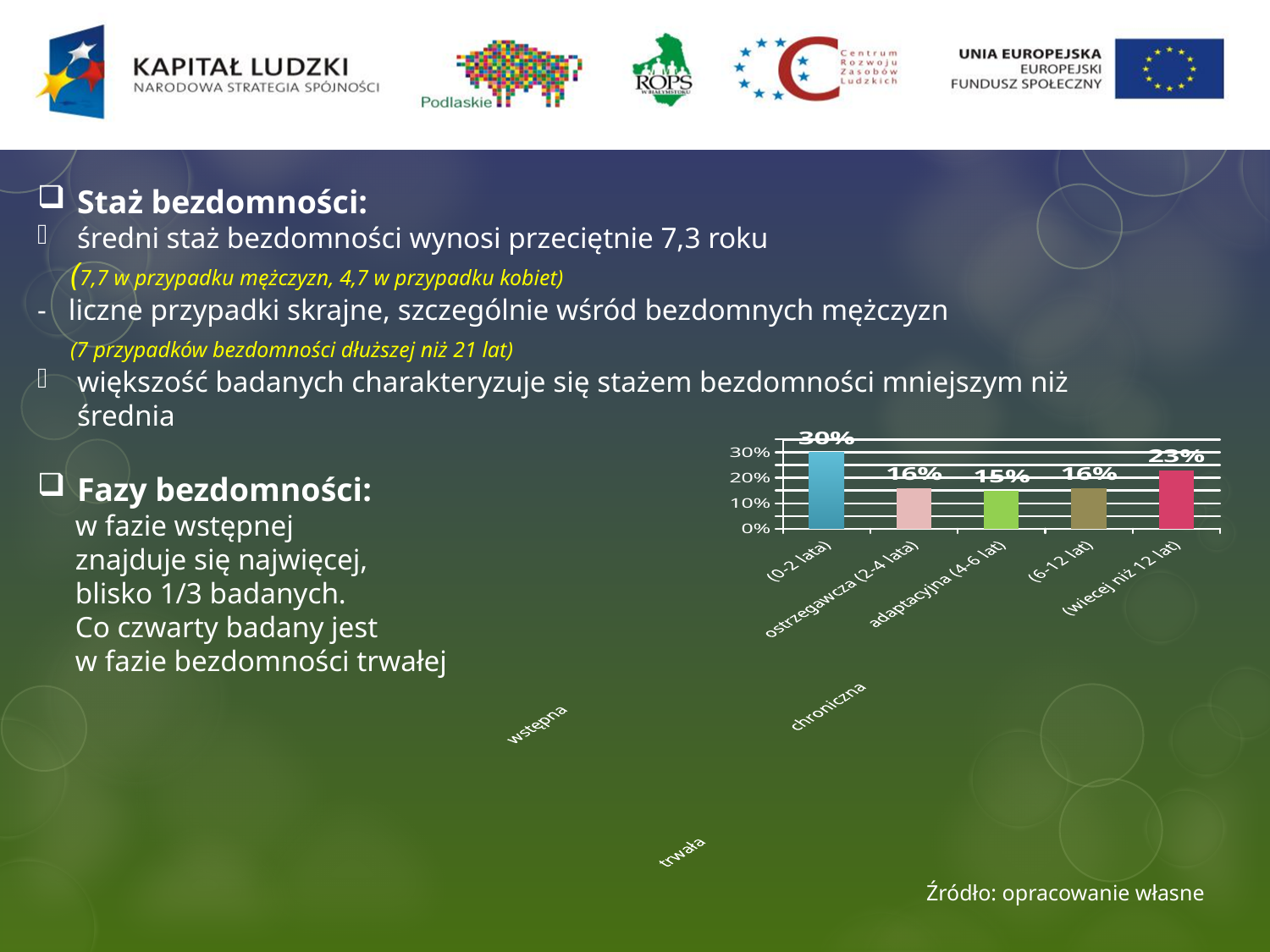
What is the highest tick value shown on the vertical axis? 30% What is the value for the (0-2 lata) category? 30% Which category has the lowest value? adaptacyjna (4-6 lat) What is the difference between the (0-2 lata) value and the (więcej niż 12 lat) value? 7% How many bars (categories) does the chart show? 5 Which category has the highest value? (0-2 lata) What is the value for ostrzegawcza (2-4 lata)? 16% What is the value for the (więcej niż 12 lat) category? 23% What kind of chart is shown on the slide? bar chart Is the value for ostrzegawcza (2-4 lata) greater or less than 20%? less What is the value for adaptacyjna (4-6 lat)? 15% Which is larger, the value for (6-12 lat) or the value for (więcej niż 12 lat)? (więcej niż 12 lat)